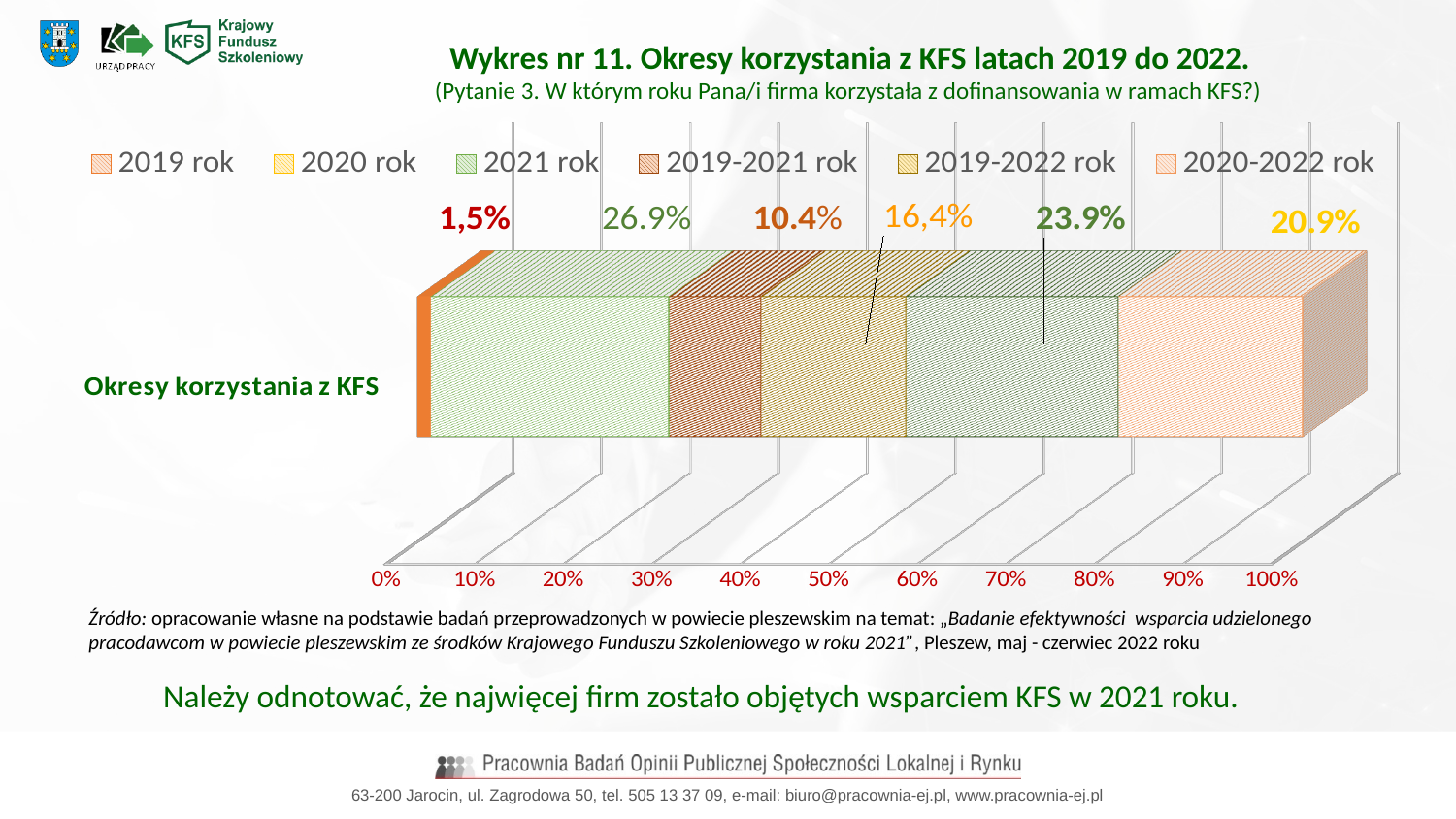
Which series has the lowest value? 2019 rok What is the value for '2019 rok'? 1,5% How many categories are shown on the vertical axis? 1 What is the difference between the value for '2021 rok' and the value for '2019 rok'? 25.4% Is the value for '2021 rok' greater or less than 20%? greater What is the title of the chart? Wykres nr 11. Okresy korzystania z KFS latach 2019 do 2022. Which is larger, the value for '2021 rok' or for '2019 rok'? 2021 rok Which series has the highest value? 2021 rok What is the value for '2021 rok'? 26.9% What type of chart is shown on the slide? bar chart What is the highest value shown on the horizontal axis? 100% How many series does the legend list? 6